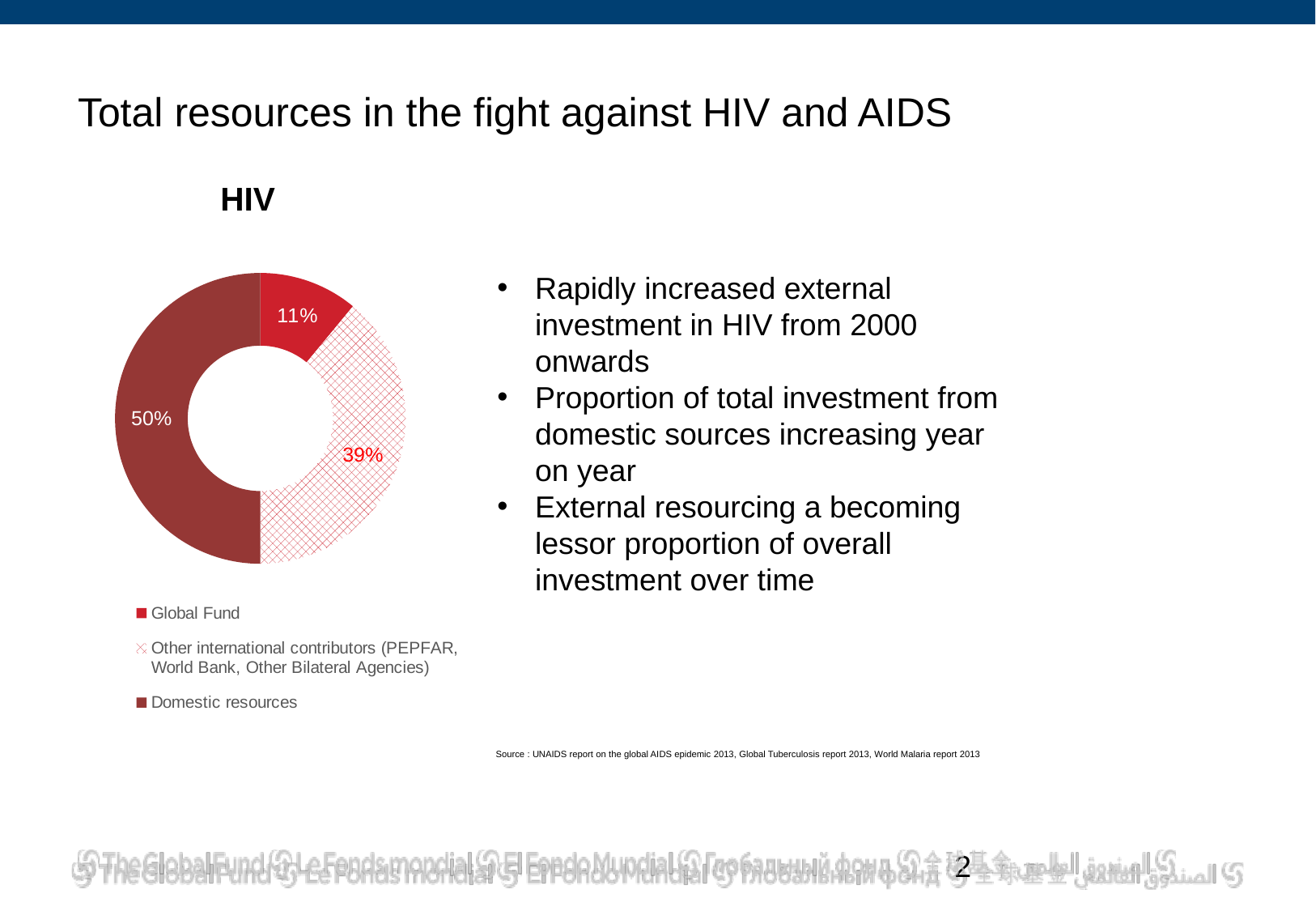
What share of HIV resources comes from Domestic resources? 50% What kind of chart is used to show the HIV resources? Doughnut chart Which source accounts for the largest share of HIV resources? Domestic resources What is the title of the chart? HIV Which legend entry is shown with a cross-hatched pattern? Other international contributors (PEPFAR, World Bank, Other Bilateral Agencies) Which is larger: the share from Other international contributors or the share from Domestic resources? Domestic resources What share of HIV resources comes from the Global Fund? 11% What share of HIV resources comes from Other international contributors (PEPFAR, World Bank, Other Bilateral Agencies)? 39% How many categories are shown in the HIV chart? 3 What is the difference in percentage points between the Other international contributors share and the Global Fund share? 28 Which source accounts for the smallest share of HIV resources? Global Fund What is the difference in percentage points between the Domestic resources share and the Global Fund share? 39